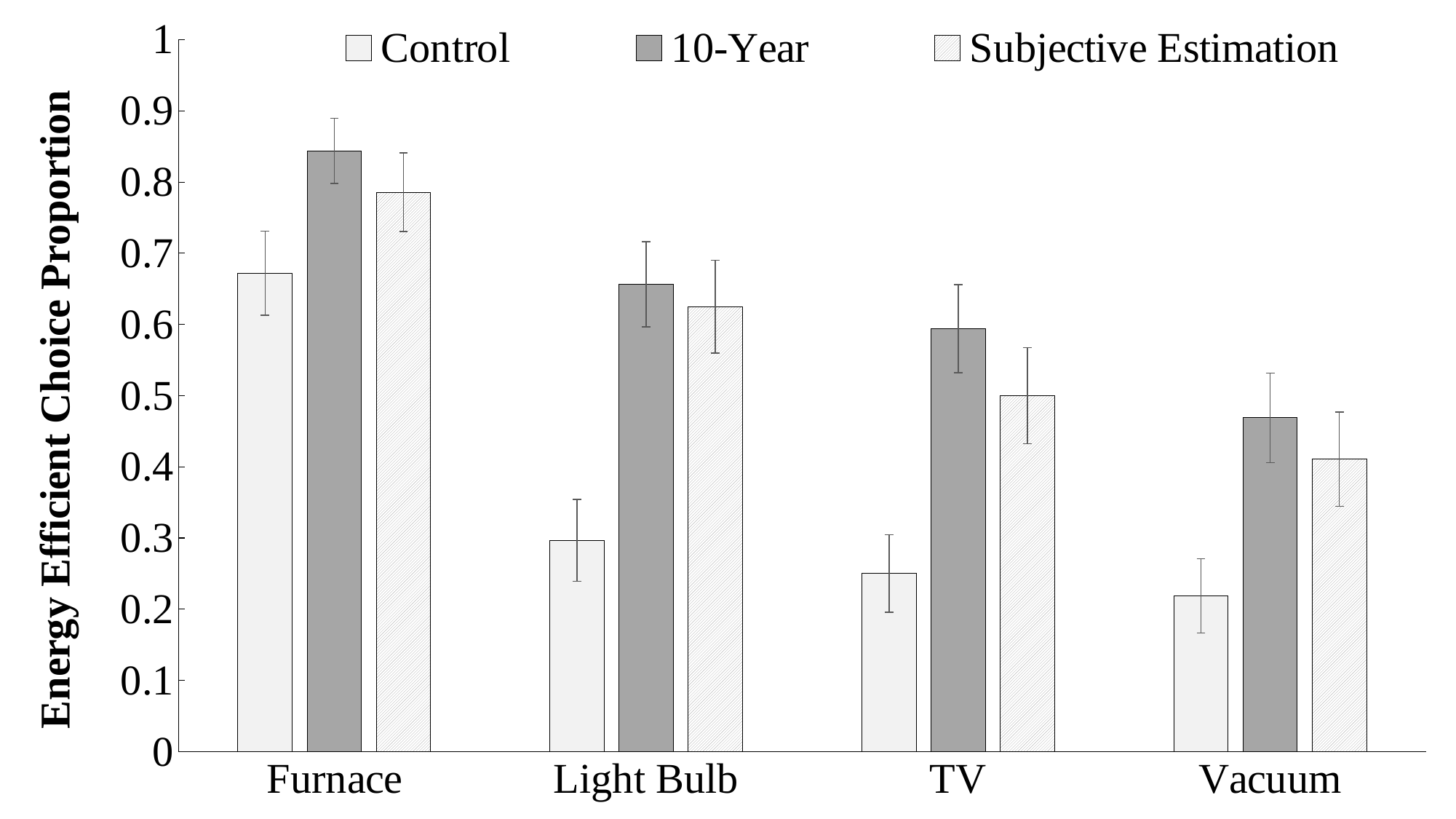
For which category is the 10-Year bar lowest? Vacuum What is the label of the y axis? Energy Efficient Choice Proportion Is the 10-Year value for Vacuum greater or less than 0.5? less How many series does the legend list? 3 For which category is the 10-Year bar highest? Furnace Which series is shown with the hatched (diagonal-striped) bars? Subjective Estimation Is the Control value for Furnace greater or less than 0.6? greater For TV, which is larger: the 10-Year value or the Subjective Estimation value? 10-Year How many product categories are shown on the x axis? 4 What kind of chart is shown on the slide? bar chart Is the Control value for TV greater or less than 0.3? less